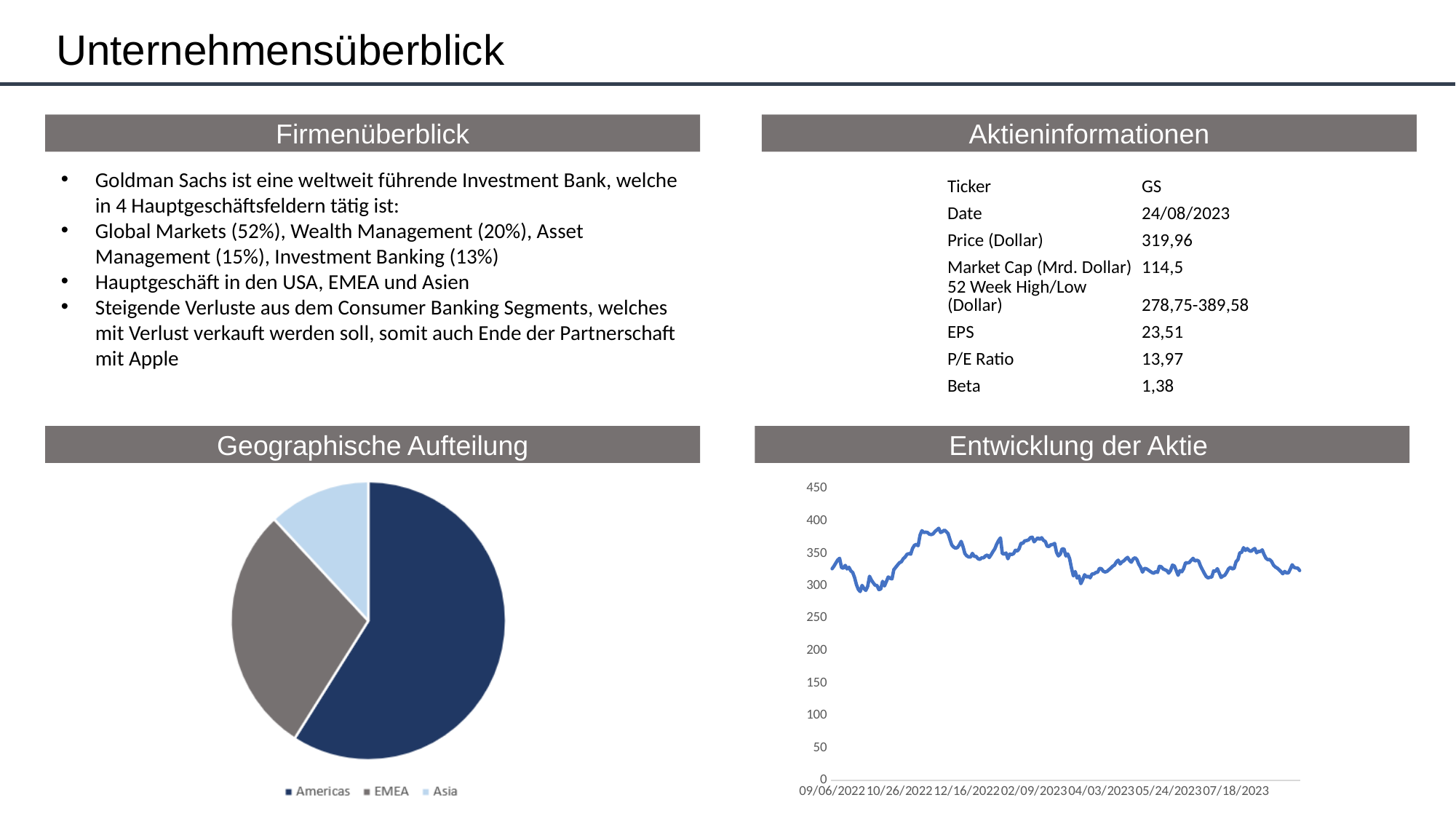
What kind of chart is shown under "Geographische Aufteilung"? pie chart In the "Geographische Aufteilung" pie chart, which is larger, the share for EMEA or the share for Asia? EMEA In the "Entwicklung der Aktie" line chart, is the highest value reached by the line greater or less than 400? less In the "Entwicklung der Aktie" line chart, what is the highest value shown on the vertical axis? 450 In the "Geographische Aufteilung" pie chart, which regions are listed in the legend? Americas, EMEA, Asia In the "Geographische Aufteilung" pie chart, which region has the largest share? Americas In the "Geographische Aufteilung" pie chart, what colour is the Asia slice? light blue In the "Entwicklung der Aktie" line chart, is the value at the first date (09/06/2022) greater or less than 300? greater In the "Geographische Aufteilung" pie chart, which is larger, the share for Americas or the share for EMEA? Americas In the "Geographische Aufteilung" pie chart, how many regions are shown? 3 In the "Geographische Aufteilung" pie chart, which region has the smallest share? Asia What kind of chart is shown under "Entwicklung der Aktie"? line chart